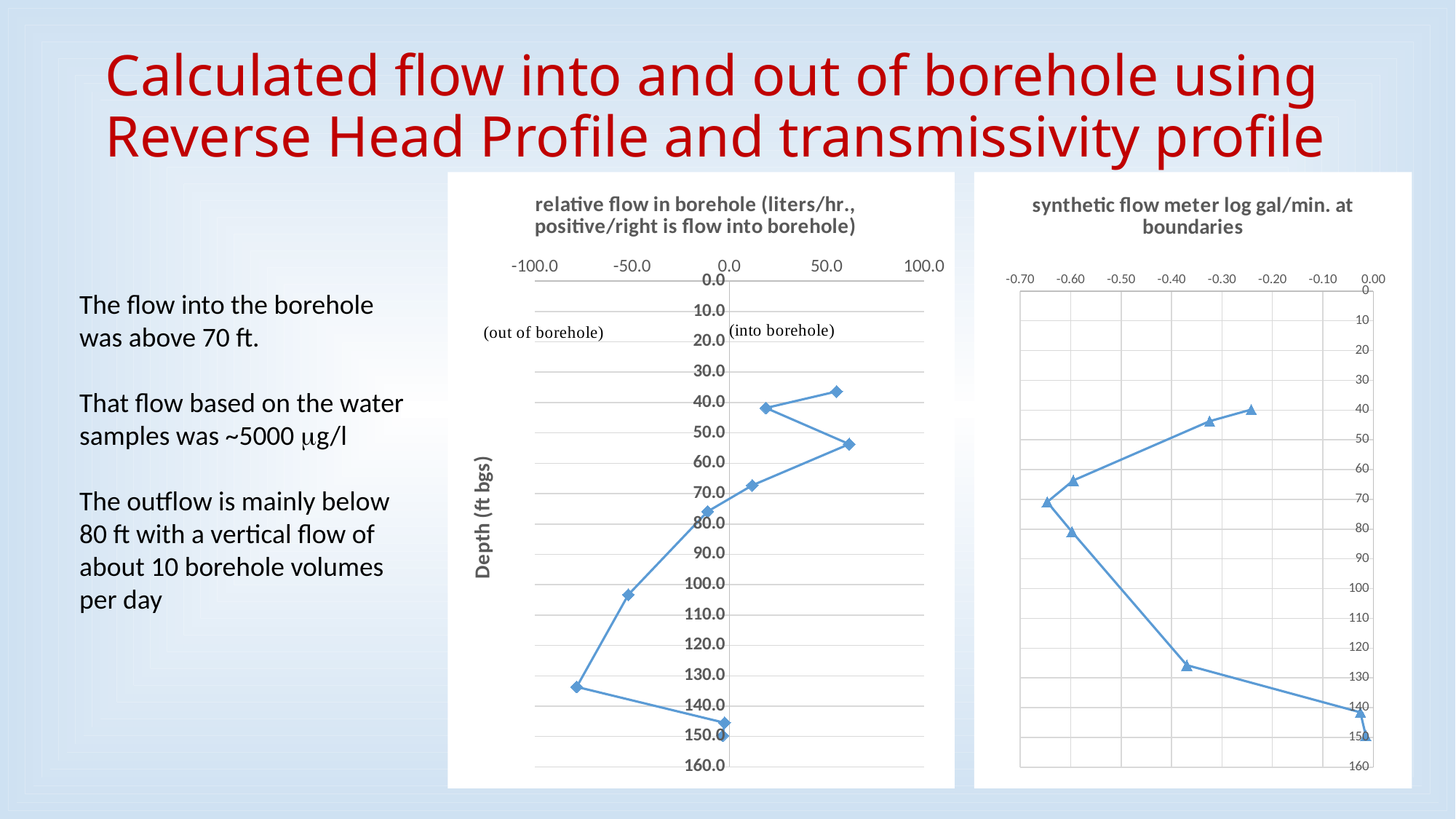
In the right chart (synthetic flow meter log), is the value of the leftmost point (at about 71 ft depth) greater or less than -0.60? less In the left chart (relative flow in borehole), is the value of the leftmost point (at about 134 ft depth) greater or less than -50.0? less What is the title of the chart on the right of the slide? synthetic flow meter log gal/min. at boundaries What kind of chart is the left chart (relative flow in borehole)? line chart In the left chart (relative flow in borehole), which side of the zero line is labelled 'into borehole'? right (positive) side In the right chart (synthetic flow meter log), is the value of the point at about 40 ft depth greater or less than -0.30? greater In the right chart (synthetic flow meter log), do the values increase or decrease between the points at about 71 ft and about 141 ft depth? increase What is the vertical axis title of the left chart (relative flow in borehole)? Depth (ft bgs)